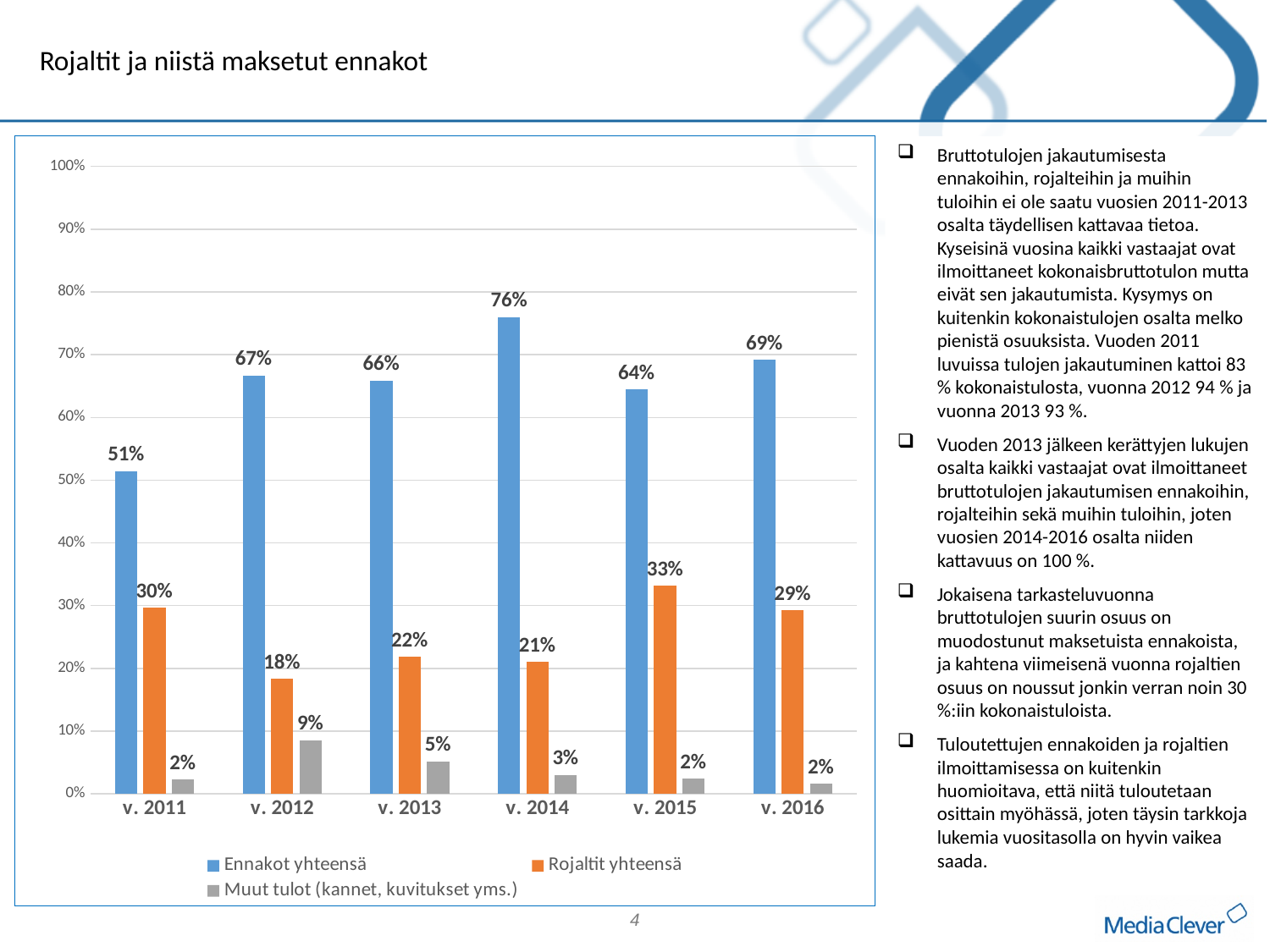
Is the value of Ennakot yhteensä for v. 2015 greater or less than 60%? greater What is the difference between Ennakot yhteensä and Rojaltit yhteensä in v. 2011? 21 percentage points What is the value of Rojaltit yhteensä for v. 2015? 33% How many years are shown on the x axis? 6 What is the value of Muut tulot (kannet, kuvitukset yms.) for v. 2012? 9% What kind of chart is shown on the slide? Bar chart Which colour represents Rojaltit yhteensä in the chart? Orange How many series does the legend list? 3 Which year has the lowest value for Rojaltit yhteensä? v. 2012 What is the value of Ennakot yhteensä for v. 2014? 76% Which is larger: Rojaltit yhteensä in v. 2013 or in v. 2016? v. 2016 Which year has the highest value for Ennakot yhteensä? v. 2014